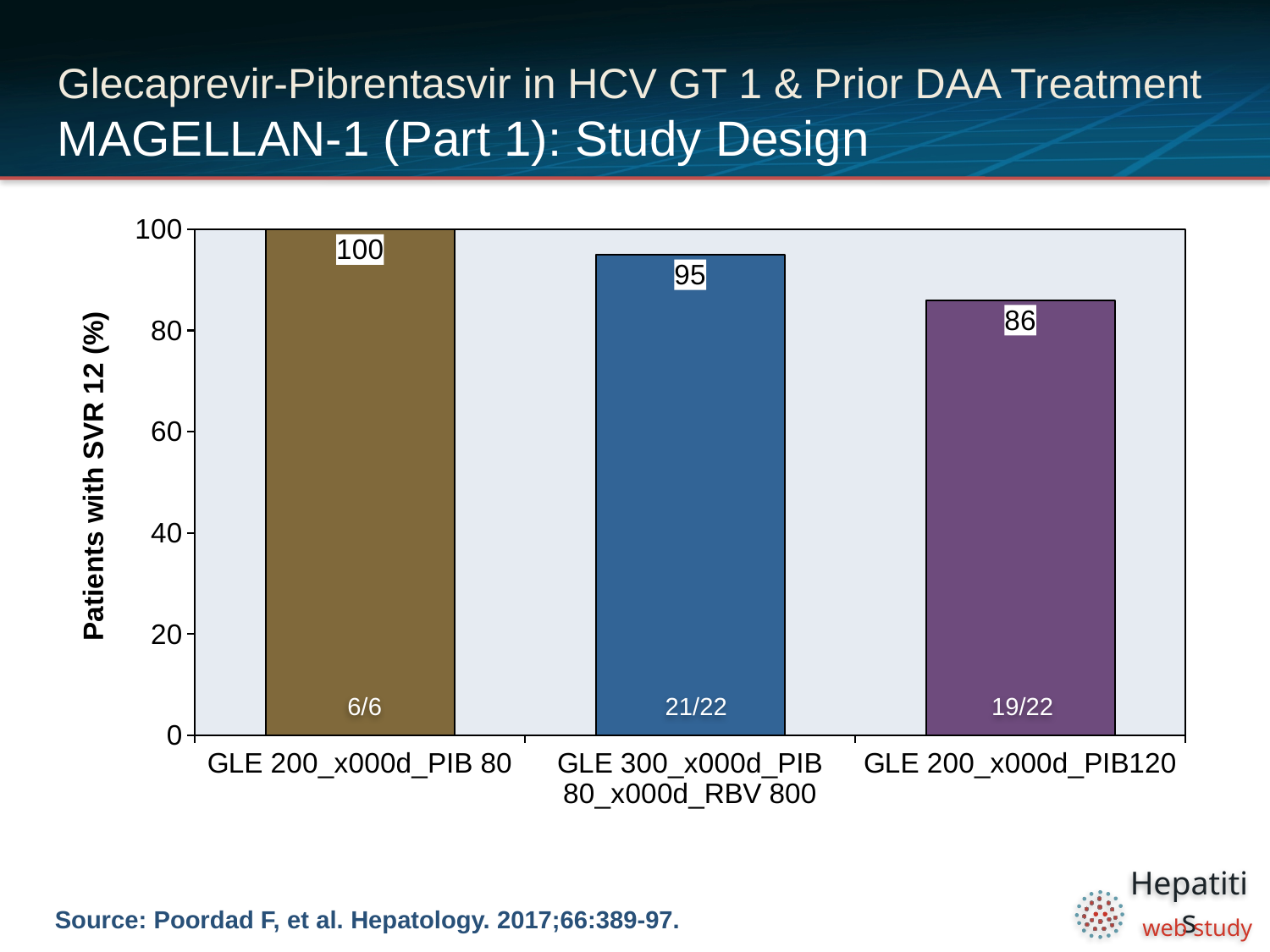
What is the difference in SVR 12 percentage between the GLE 200 / PIB 80 arm and the GLE 200 / PIB120 arm? 14 Which treatment arm has the highest SVR 12 percentage? GLE 200 / PIB 80 How many bars (categories) are plotted in the chart? 3 What patient fraction is printed inside the GLE 200 / PIB120 bar? 19/22 What is the SVR 12 percentage for the third bar, GLE 200 / PIB120? 86 Which treatment arm has the lowest SVR 12 percentage? GLE 200 / PIB120 What type of chart is shown on the slide? bar chart What is the SVR 12 percentage for the middle bar, GLE 300 / PIB 80 / RBV 800? 95 Which has a higher SVR 12 percentage: the GLE 300 / PIB 80 / RBV 800 arm or the GLE 200 / PIB120 arm? GLE 300 / PIB 80 / RBV 800 What patient fraction is printed inside the GLE 300 / PIB 80 / RBV 800 bar? 21/22 What is the SVR 12 percentage for the first bar, GLE 200 / PIB 80? 100 What is the label of the y-axis? Patients with SVR 12 (%)